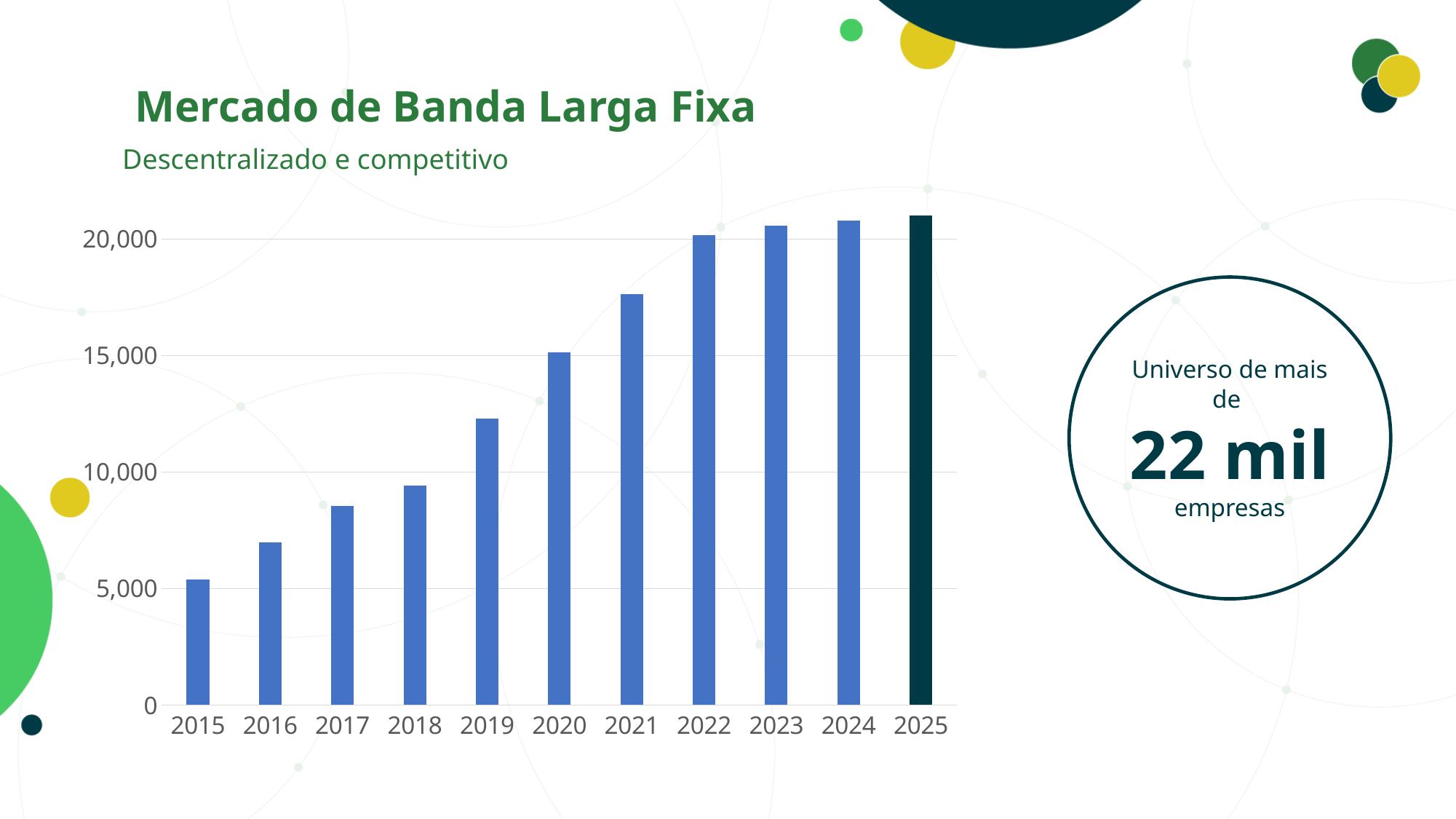
Which year has the highest bar in the chart? 2025 Which year has the larger value, 2017 or 2020? 2020 Is the value for 2019 greater or less than 10,000? greater What kind of chart is shown on the slide? Bar chart Which year's bar is drawn in a different (dark) colour from the others? 2025 Is the value for 2018 greater or less than 10,000? less Is the value for 2021 greater or less than 20,000? less Do the values rise or fall from 2015 to 2025? Rise What is the title of the slide containing the chart? Mercado de Banda Larga Fixa Which year has the lowest bar in the chart? 2015 How many years are shown on the x axis of the chart? 11